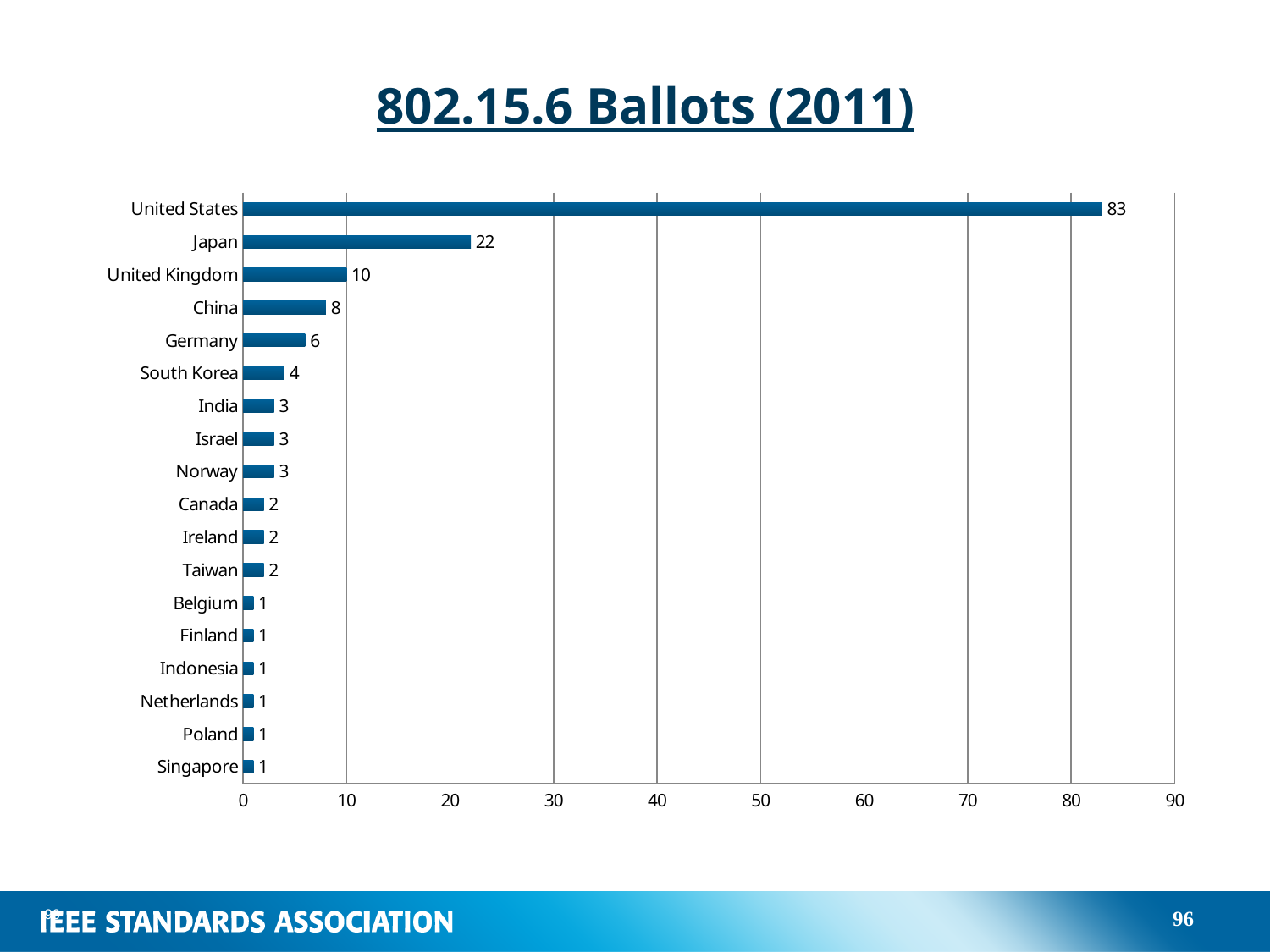
How many countries have a value of 1? 6 What is the difference between the values for United States and Japan? 61 What kind of chart is shown on the slide? bar chart What is the value for Germany? 6 Which country has the highest number of ballots? United States What is the value for United States? 83 Which is larger, the value for South Korea or the value for India? South Korea What is the value for Japan? 22 How many countries are shown in the chart? 18 What is the title of the chart? 802.15.6 Ballots (2011) What is the difference between the values for United Kingdom and China? 2 Is the value for Japan greater or less than 20? greater